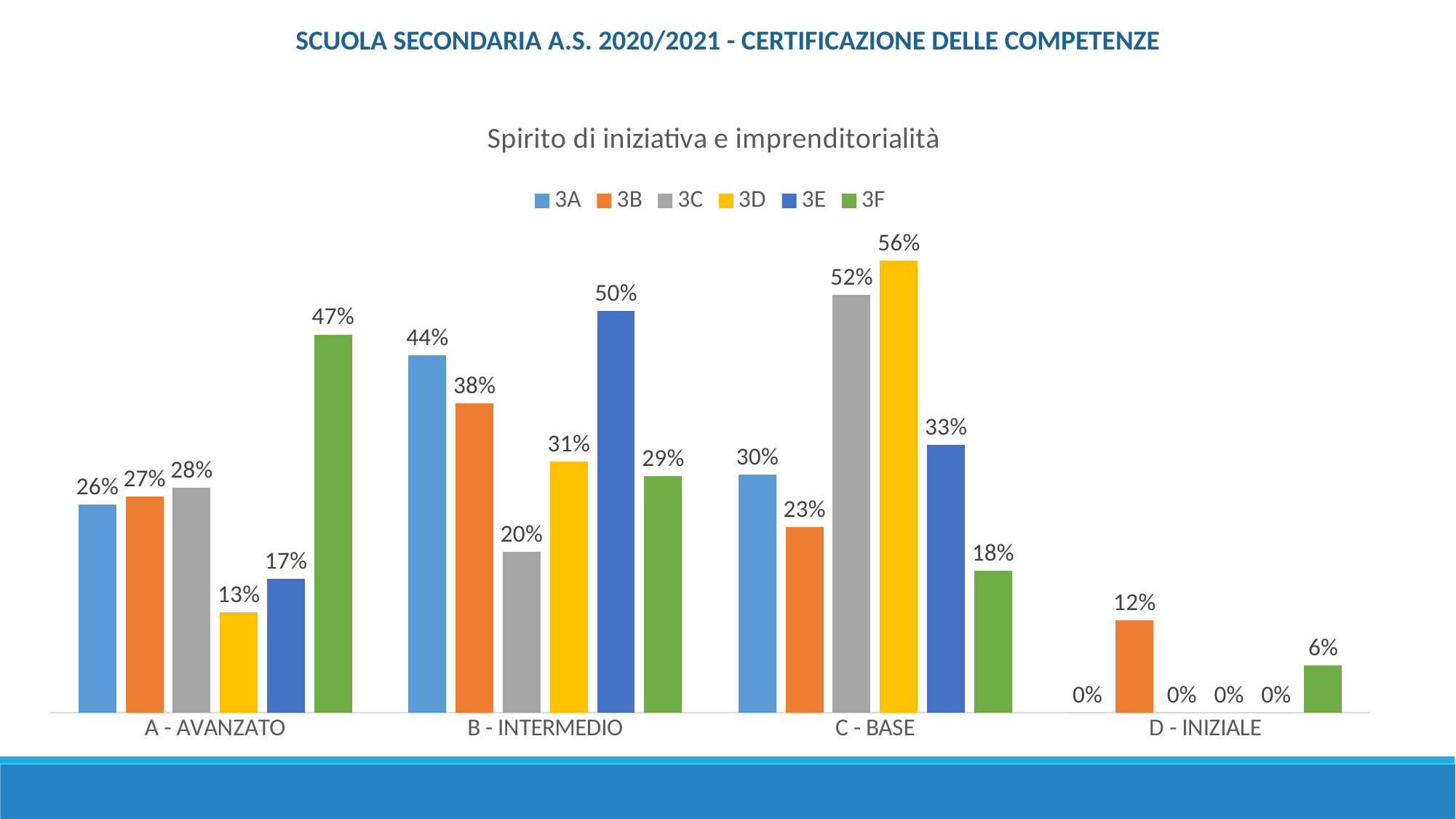
Which is larger in the C - BASE category: the value for 3E or the value for 3F? 3E Which series has the lowest value in the A - AVANZATO category? 3D Which series has the highest value in the C - BASE category? 3D What kind of chart is shown on the slide? Bar chart What is the title of the chart? Spirito di iniziativa e imprenditorialità What is the value for 3B in the D - INIZIALE category? 12% What is the value for 3E in the B - INTERMEDIO category? 50% How many categories are shown on the x axis? 4 What is the value for 3F in the A - AVANZATO category? 47% What is the value for 3D in the C - BASE category? 56% How many series does the legend list? 6 What is the difference between the 3A and 3C values in the B - INTERMEDIO category? 24%